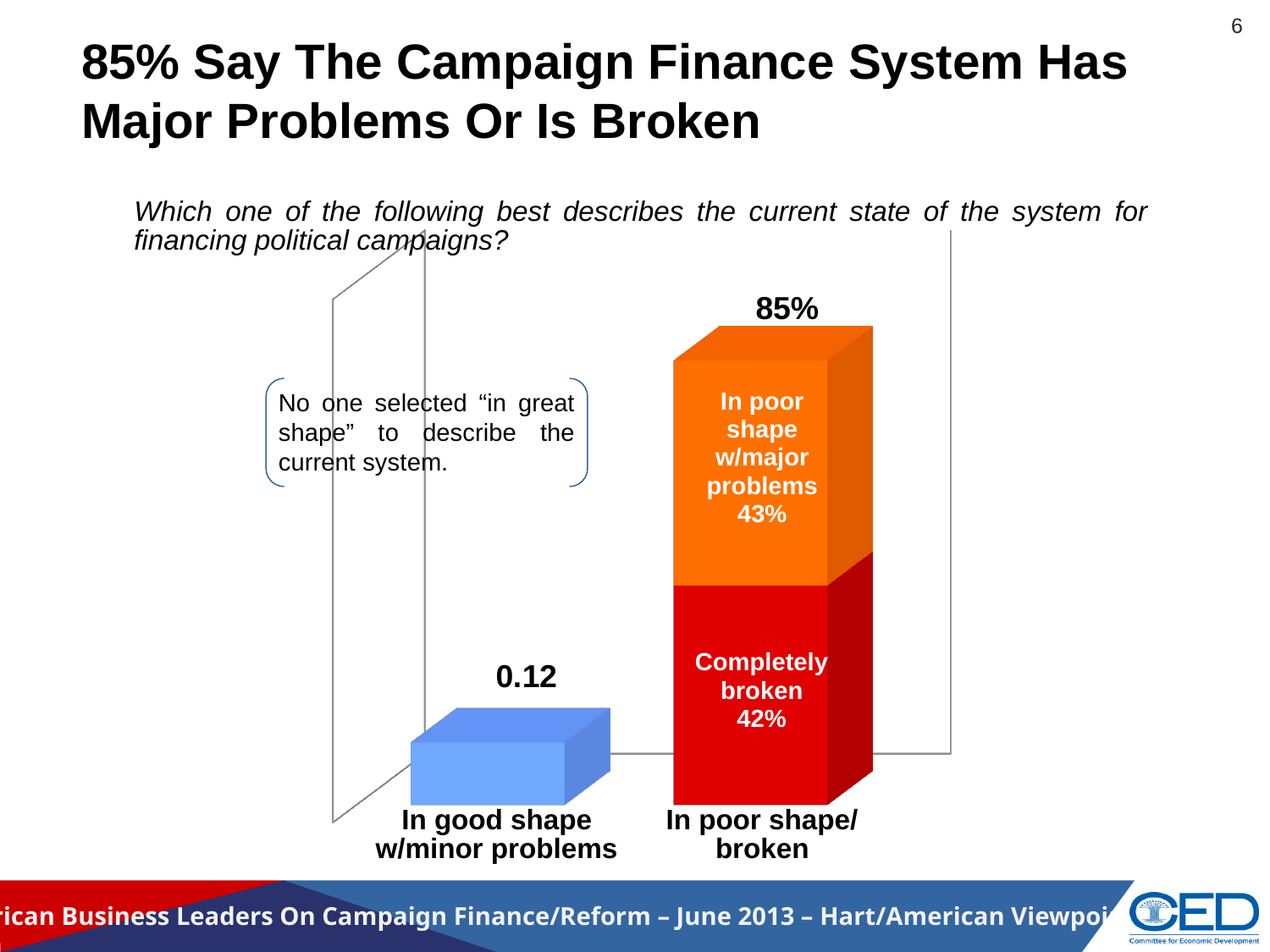
What is the difference between the 'In poor shape w/major problems' segment and the 'Completely broken' segment? 1% What value is shown for the 'In good shape w/minor problems' bar? 0.12 What percentage is shown for the 'Completely broken' segment? 42% How many categories are shown on the x axis of the chart? 2 Which category has the lowest value? In good shape w/minor problems Which segment is larger, 'In poor shape w/major problems' or 'Completely broken'? In poor shape w/major problems What total value is labeled above the 'In poor shape/broken' bar? 85% Which category has the highest value? In poor shape/broken What is the total of the two segments in the 'In poor shape/broken' stacked bar? 85% According to the callout box on the chart, how many respondents selected 'in great shape'? No one What percentage is shown for the 'In poor shape w/major problems' segment? 43% What kind of chart is shown on the slide? Bar chart